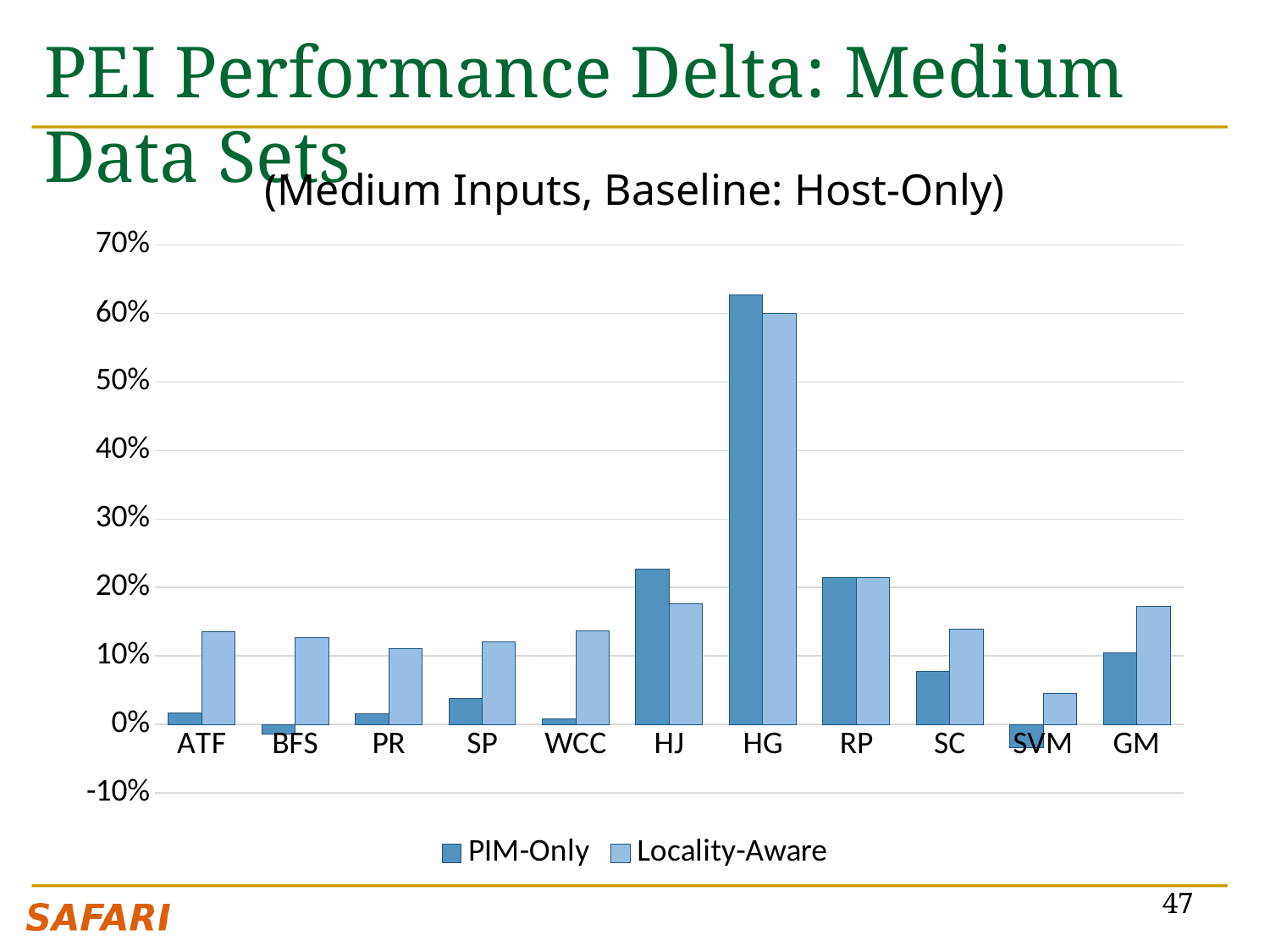
Is the PIM-Only value for SP greater or less than 10%? less For HJ, which series has the larger value, PIM-Only or Locality-Aware? PIM-Only Which category has the highest Locality-Aware value? HG How many series does the chart's legend list? 2 Which category has the lowest Locality-Aware value? SVM How many categories are shown along the x axis of the chart? 11 For ATF, which series has the larger value, PIM-Only or Locality-Aware? Locality-Aware Is the Locality-Aware value for GM greater or less than 20%? less Is the PIM-Only value for HG greater or less than 60%? greater What kind of chart is shown on the slide? bar chart Which category has the highest PIM-Only value? HG What is the title shown above the chart? (Medium Inputs, Baseline: Host-Only)